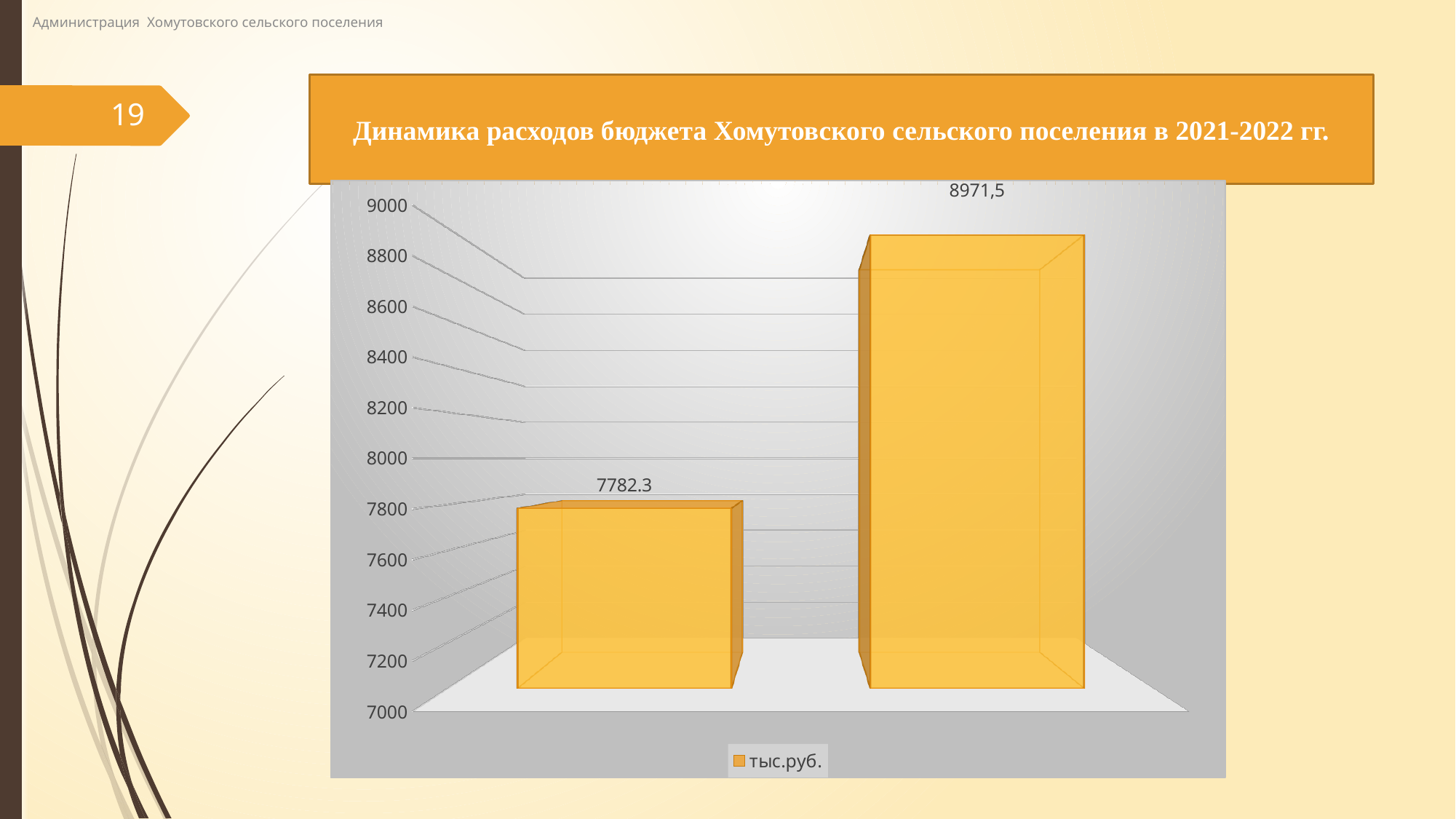
Is the value of the right bar greater or less than 8800? greater Is the value of the left bar greater or less than 8000? less Which bar is the tallest, the left one or the right one? the right bar What is the value shown on the data label of the left bar? 7782.3 What kind of chart is shown on the slide? bar chart How many series does the legend list? 1 What is the value shown on the data label of the right bar? 8971,5 Which bar is the shortest, the left one or the right one? the left bar Do the bar values rise or fall from left to right? rise Is the value of the right bar larger or smaller than the value of the left bar? larger How many bars are plotted in the chart? 2 What is the legend entry of the chart? тыс.руб.